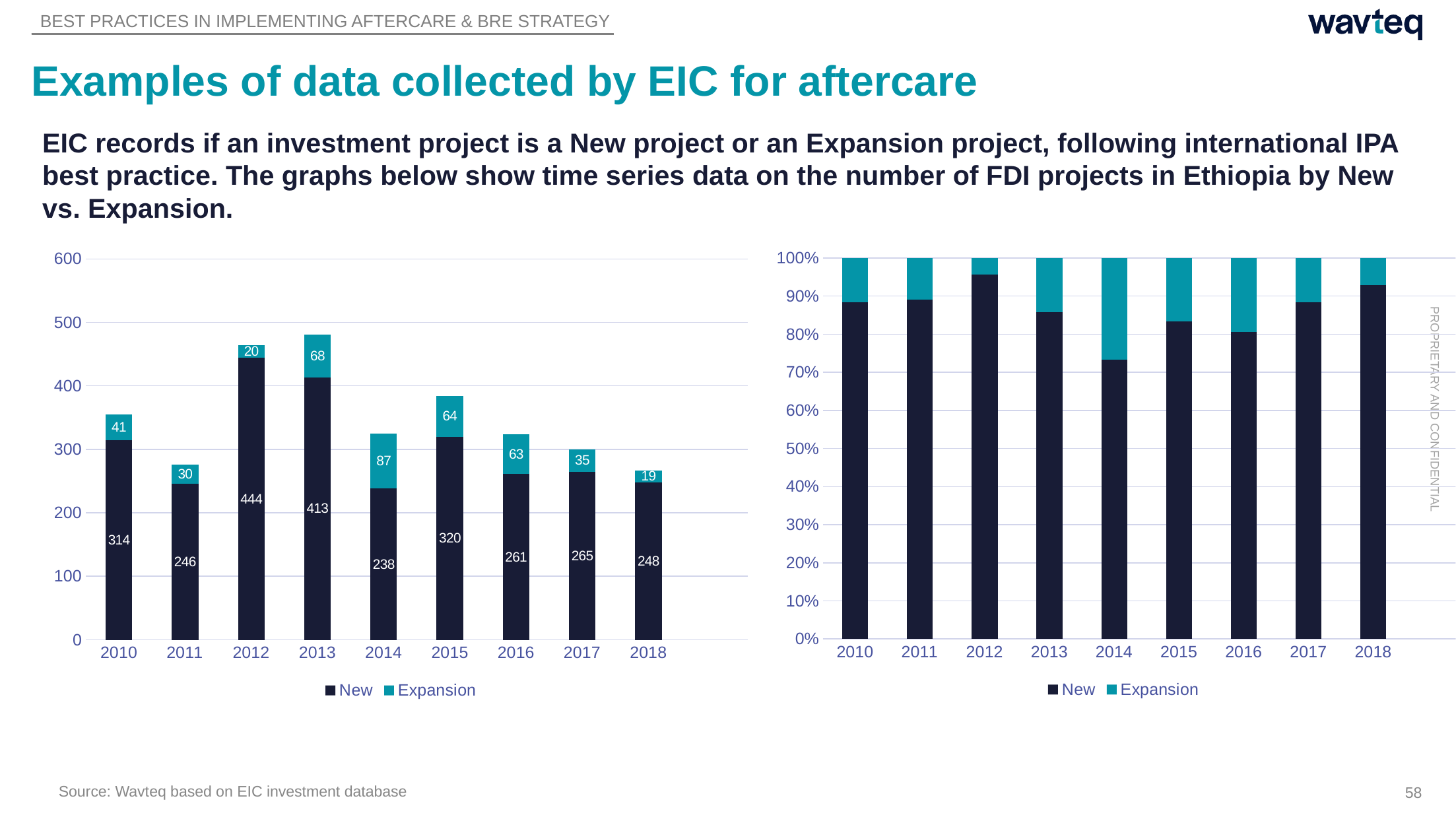
In the left chart, which year has the lowest value for Expansion? 2018 How many series does the legend of the right chart list? 2 In the right chart, is the share for New in 2014 greater or less than 80%? less In the left chart, what is the total of the stacked bar for 2013? 481 What kind of chart is the chart on the right? Stacked bar chart In the left chart, which is larger: Expansion in 2015 or Expansion in 2016? Expansion in 2015 In the right chart, is the share for New in 2012 greater or less than 90%? greater In the left chart, what is the value for Expansion in 2014? 87 In the left chart, what is the difference between the New values for 2013 and 2014? 175 How many years are shown on the x axis of the left chart? 9 In the left chart, which year has the highest value for New? 2012 In the left chart, what is the value for New in 2012? 444